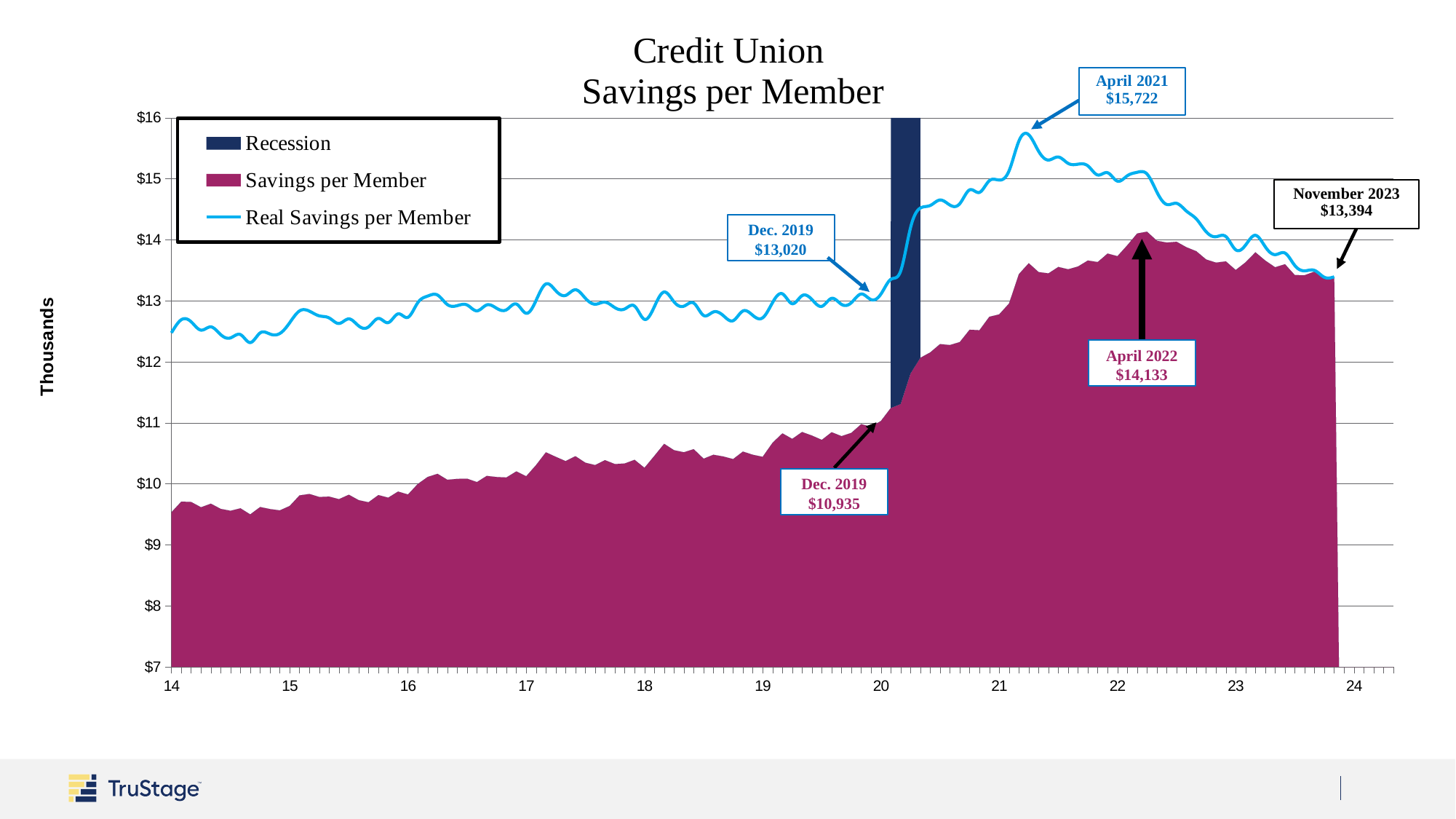
Is Savings per Member at the start of 2014 greater or less than $10? less How much higher was Savings per Member in April 2022 than in Dec. 2019? $3,198 Does Savings per Member generally rise or fall from 2014 to 2022? rise Which is larger: Real Savings per Member in April 2021 or Savings per Member in April 2022? Real Savings per Member in April 2021 What was Savings per Member in April 2022? $14,133 What was Real Savings per Member in Dec. 2019? $13,020 What was Savings per Member in Dec. 2019? $10,935 What was Real Savings per Member in April 2021? $15,722 What is the difference between Real Savings per Member and Savings per Member in Dec. 2019? $2,085 How many entries does the legend list? 3 What value is annotated for November 2023? $13,394 What does the dark blue vertical bar in the chart represent? Recession